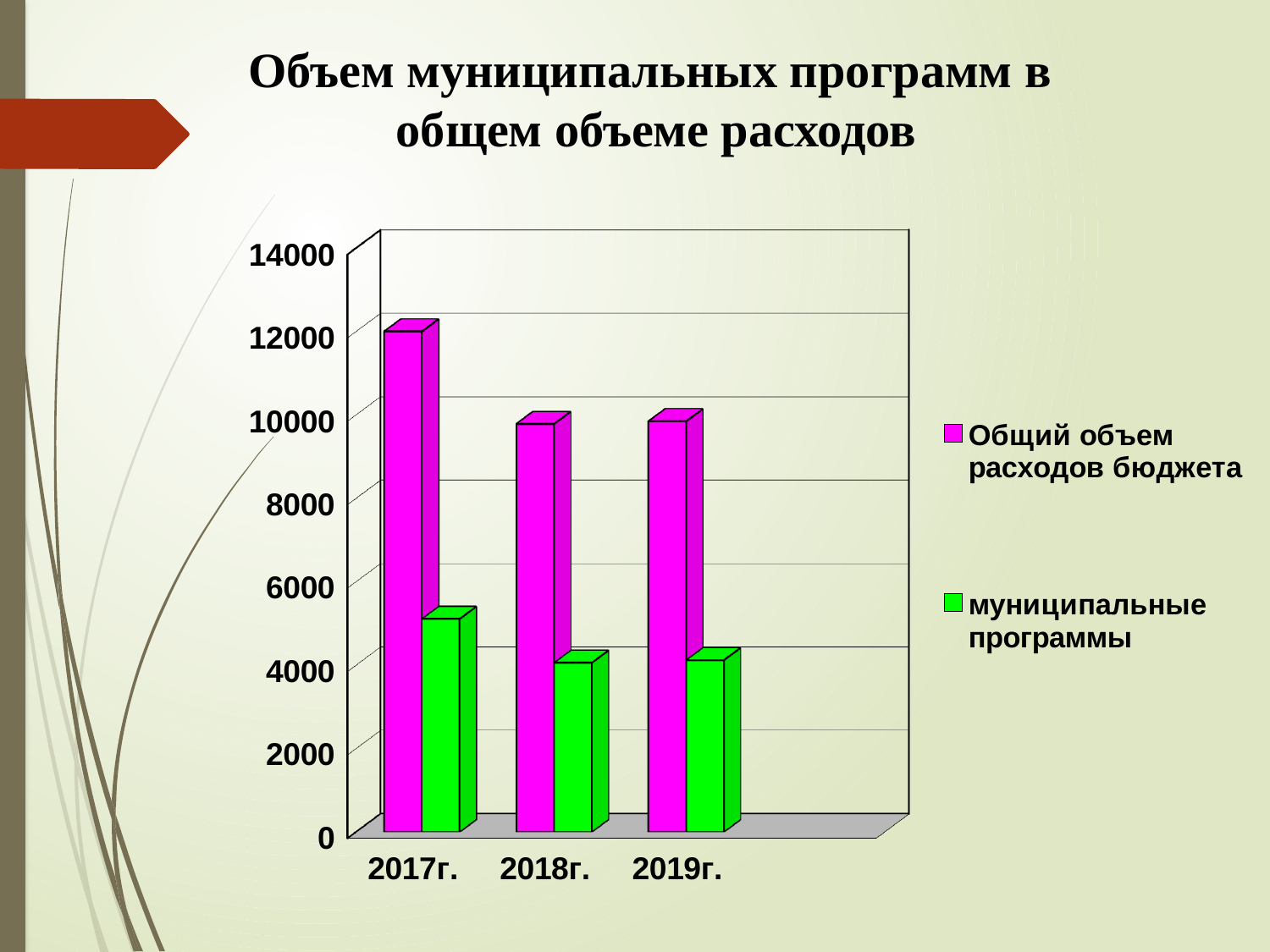
Is the value for "Общий объем расходов бюджета" in 2018г. greater or less than 8000? greater Which is larger: "Общий объем расходов бюджета" in 2017г. or in 2018г.? 2017г. Does the value for "Общий объем расходов бюджета" rise or fall from 2017г. to 2018г.? fall How many series does the legend list? 2 In which year is the value for "муниципальные программы" highest? 2017г. What kind of chart is shown on the slide? bar chart Is the value for "муниципальные программы" in 2019г. greater or less than 6000? less How many years (categories) are shown on the x axis? 3 Is the value for "муниципальные программы" in 2017г. greater or less than 6000? less Which colour represents "муниципальные программы" in the chart? green In which year is the value for "Общий объем расходов бюджета" highest? 2017г.